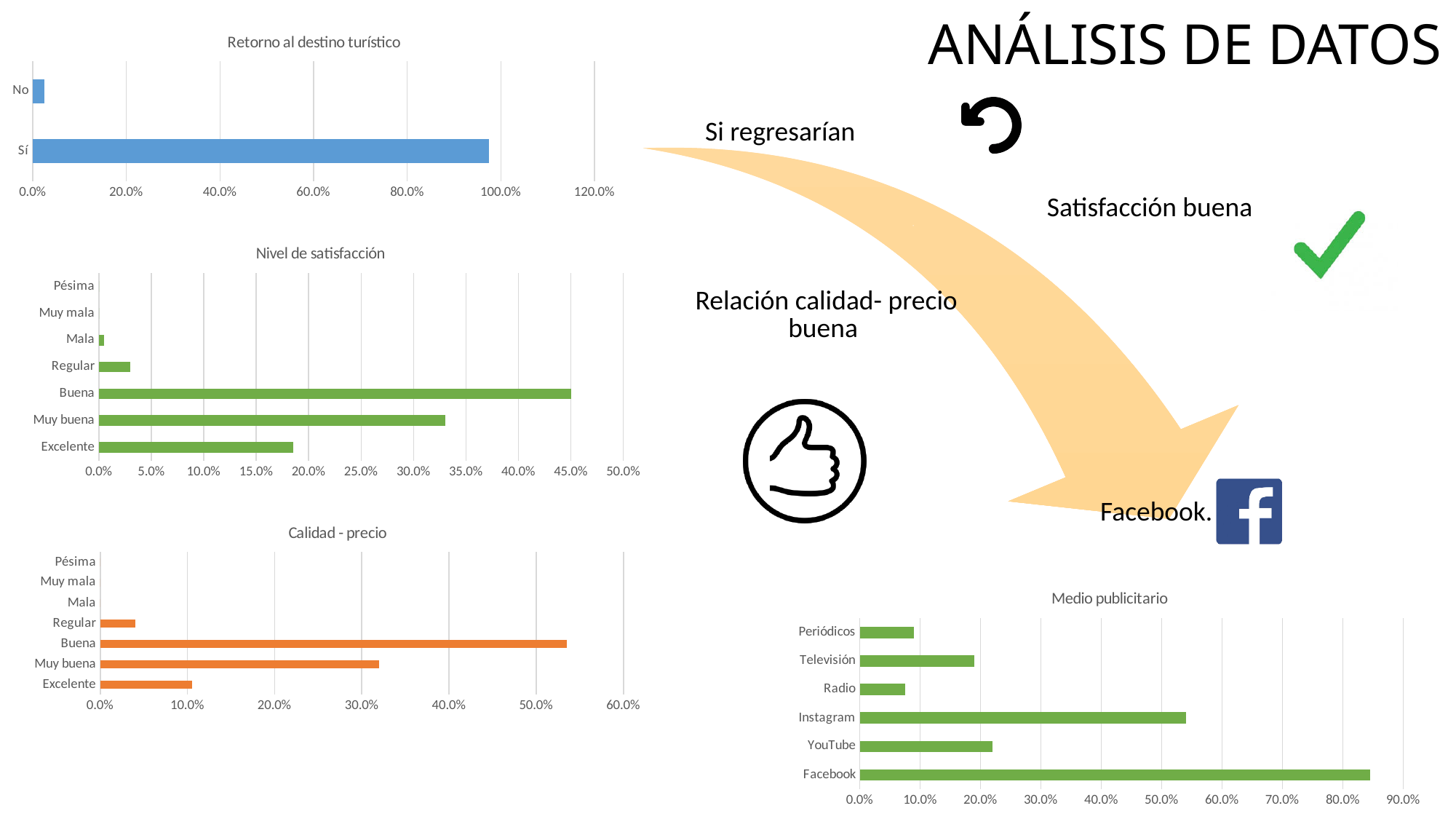
What kind of chart is the 'Medio publicitario' chart? Bar chart In the 'Retorno al destino turístico' chart, which category has the highest value? Sí In the 'Nivel de satisfacción' chart, which category has the highest value? Buena How many categories are shown in the 'Medio publicitario' chart? 6 In the 'Medio publicitario' chart, is the value for Instagram greater or less than 50.0%? greater In the 'Calidad - precio' chart, is the value for Buena greater or less than 50.0%? greater In the 'Calidad - precio' chart, which is larger, the value for Muy buena or the value for Excelente? Muy buena In the 'Retorno al destino turístico' chart, is the value for No greater or less than 20.0%? less In the 'Medio publicitario' chart, which category has the highest value? Facebook How many categories are shown in the 'Nivel de satisfacción' chart? 7